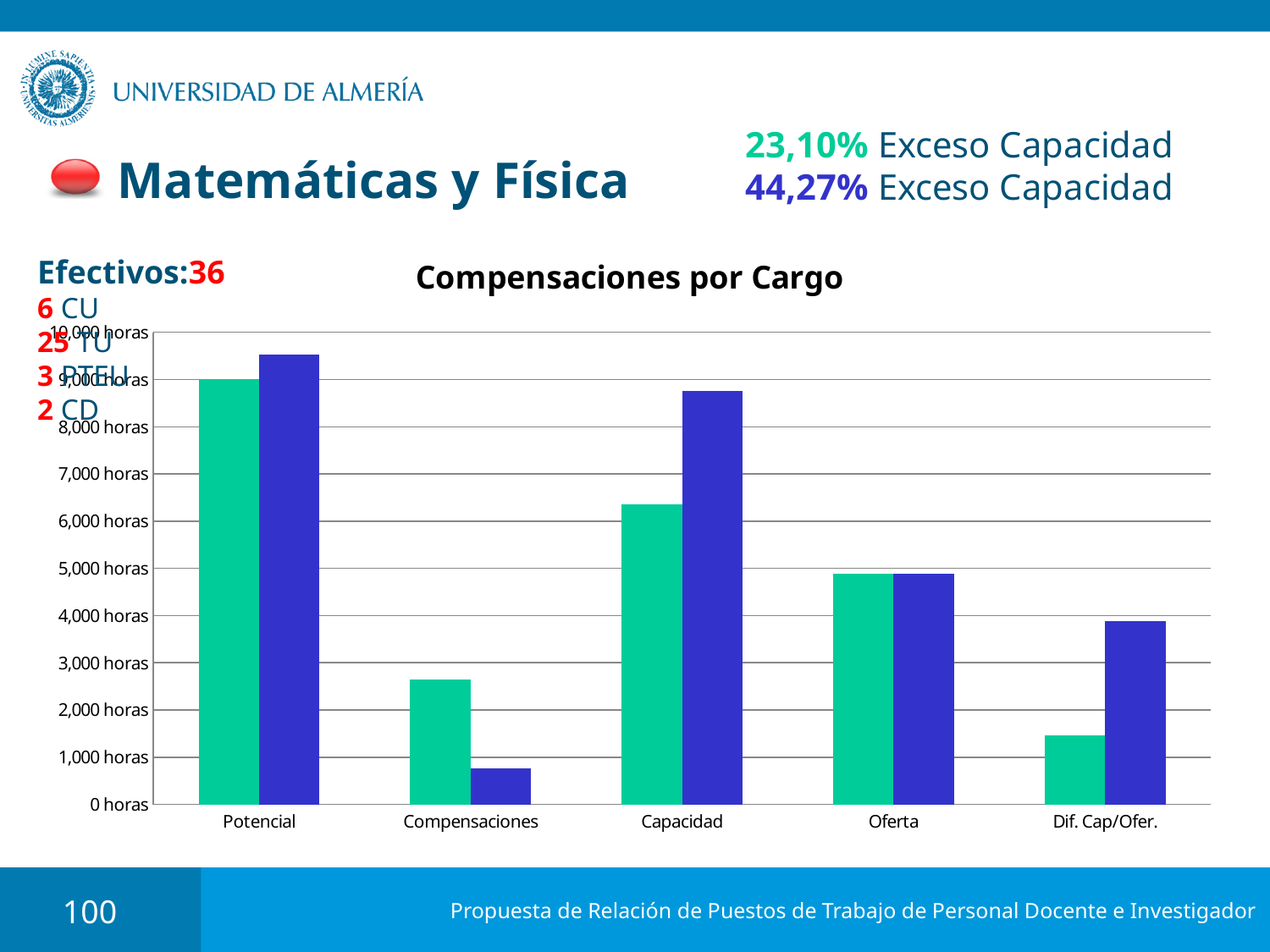
Which category has the tallest green bar in the "Compensaciones por Cargo" chart? Potencial How many categories are shown on the x axis of the "Compensaciones por Cargo" chart? 5 What kind of chart is shown under the title "Compensaciones por Cargo"? bar chart Is the blue bar for Dif. Cap/Ofer. greater or less than 3,000 horas? greater Which category has the shortest blue bar in the "Compensaciones por Cargo" chart? Compensaciones For Compensaciones, which bar is taller, the green one or the blue one? the green one Is the blue bar for Compensaciones greater or less than 1,000 horas? less Is the green bar for Capacidad greater or less than 6,000 horas? greater For Capacidad, which bar is taller, the green one or the blue one? the blue one What is the title of the chart on the slide? Compensaciones por Cargo What is the label of the highest tick on the y axis of the "Compensaciones por Cargo" chart? 10,000 horas